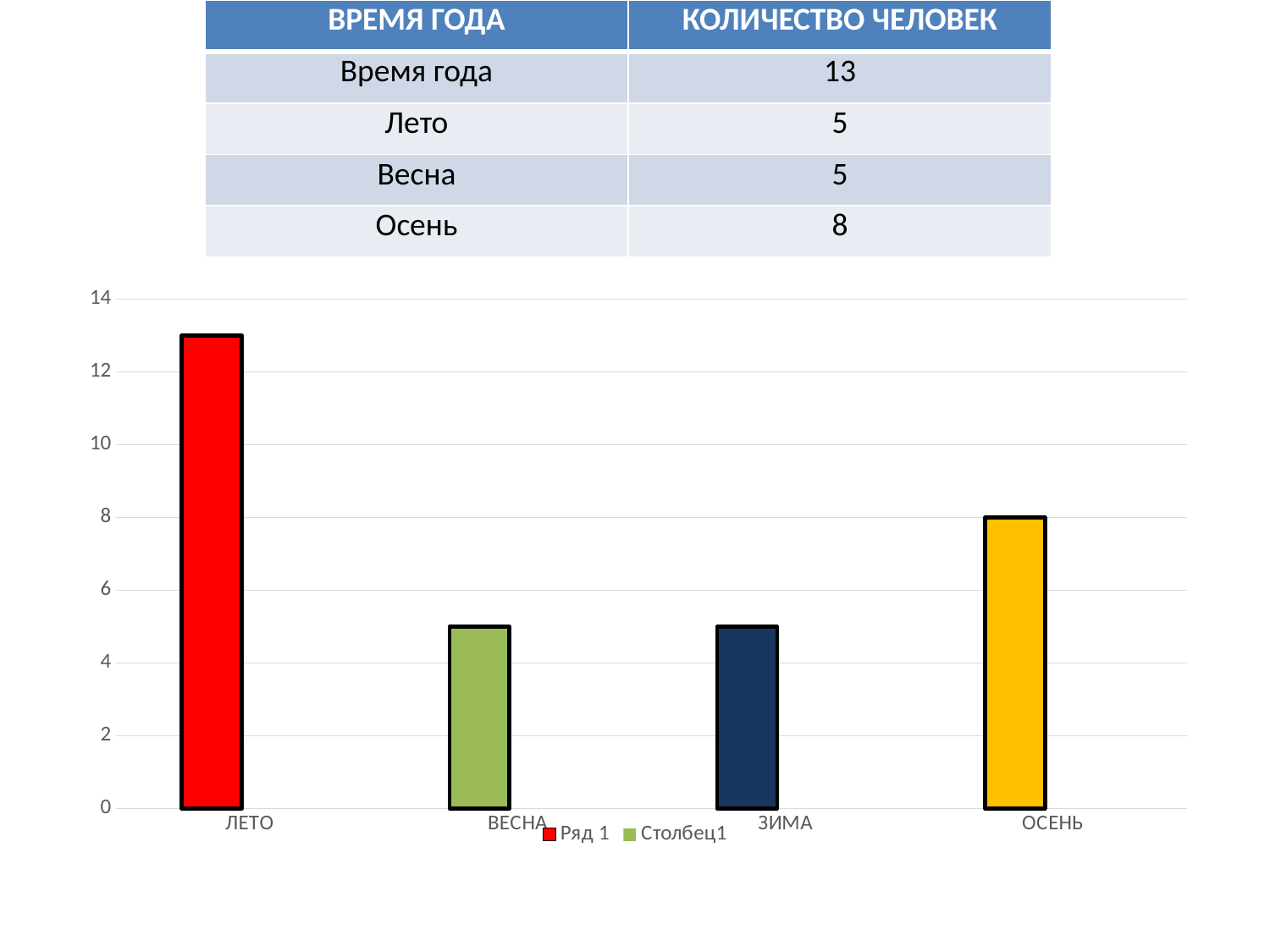
What is the value of the bar for ОСЕНЬ? 8 Which category has the highest bar in the chart? ЛЕТО What kind of chart is shown on the slide? bar chart Is the value for ЛЕТО greater or less than 12? greater How many series does the chart legend list? 2 What colour is the bar for ЛЕТО? red Is the value for ЗИМА greater or less than 4? greater Is the value for ВЕСНА greater or less than 6? less Which is larger, the bar for ЛЕТО or the bar for ОСЕНЬ? ЛЕТО What are the two entries listed in the chart legend? Ряд 1 and Столбец1 How many categories are shown on the x axis of the chart? 4 Which is larger, the bar for ОСЕНЬ or the bar for ВЕСНА? ОСЕНЬ